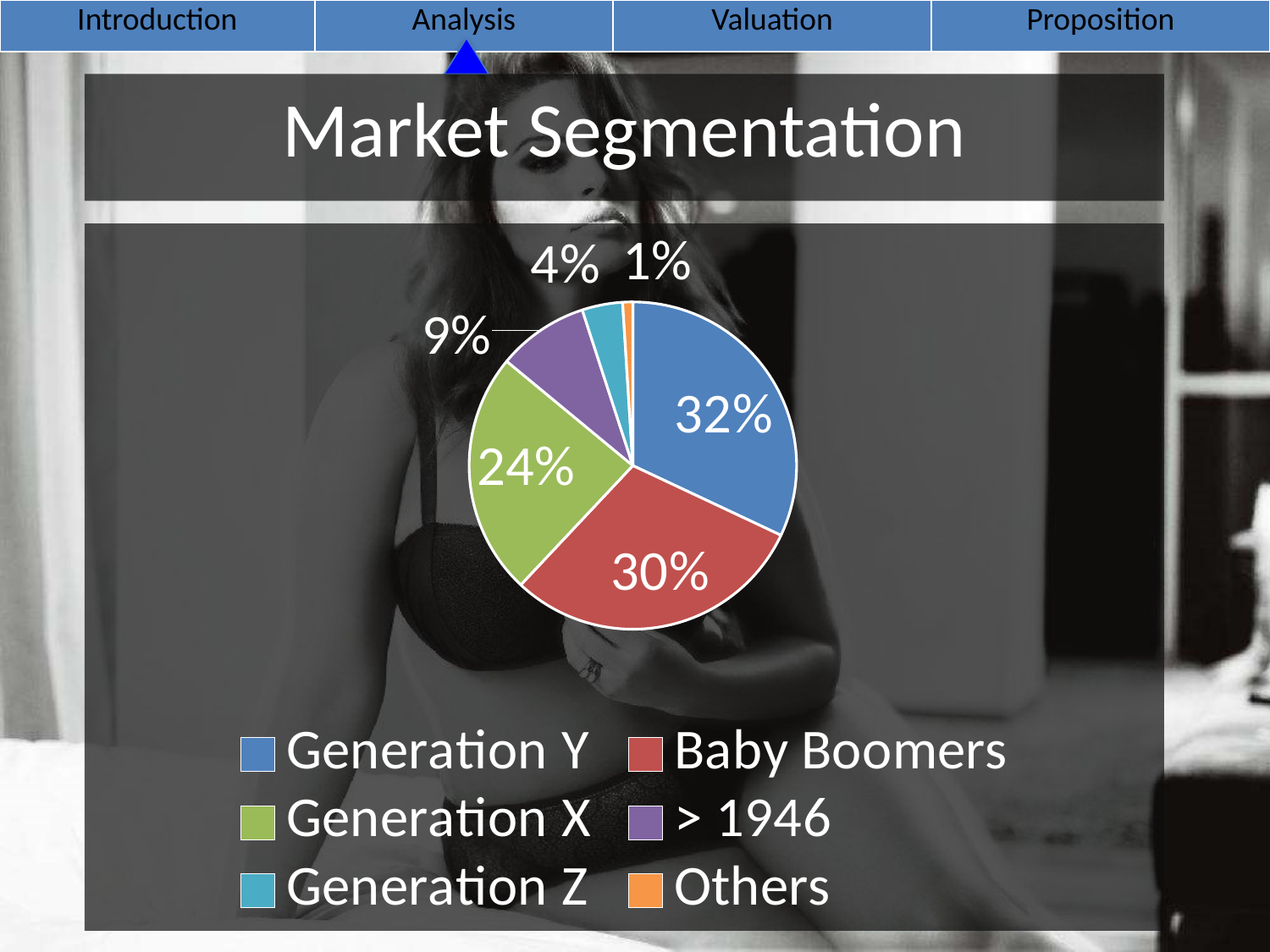
How many segments does the pie chart have? 6 What kind of chart is shown on the slide? pie chart Which segment has the largest share of the pie? Generation Y What is the title of the slide containing the pie chart? Market Segmentation What share of the pie does Generation X hold? 24% What share of the pie does Generation Y hold? 32% What share of the pie does the > 1946 segment hold? 9% What is the difference in percentage points between Generation Y and Generation X? 8 What share of the pie does Baby Boomers hold? 30% Which segment has the smallest share of the pie? Others What share of the pie does Generation Z hold? 4% Which is larger, the share for Baby Boomers or the share for Generation X? Baby Boomers